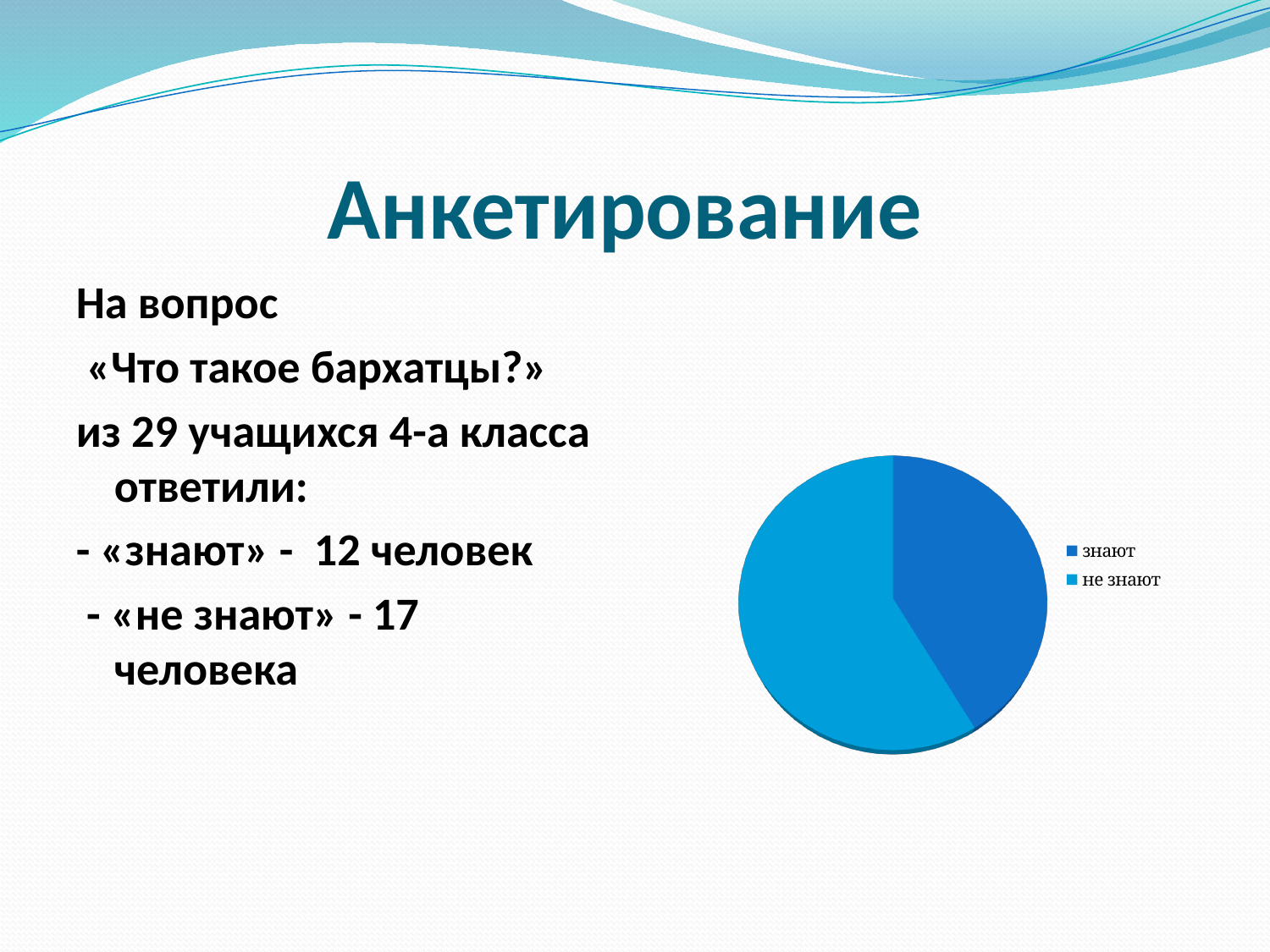
According to the slide, how many pupils answered «знают»? 12 человек What kind of chart is shown on the slide? pie chart Which category has the smallest slice in the pie chart? знают How many more pupils answered «не знают» than «знают»? 5 Which category has the largest slice in the pie chart? не знают According to the slide, how many pupils answered «не знают»? 17 человека Which slice is larger in the pie chart, «знают» or «не знают»? не знают How many entries does the legend of the pie chart list? 2 How many pupils in total are represented in the pie chart? 29 How many slices does the pie chart have? 2 Which legend entry is shown in the darker blue colour? знают What are the two legend entries of the pie chart? знают, не знают